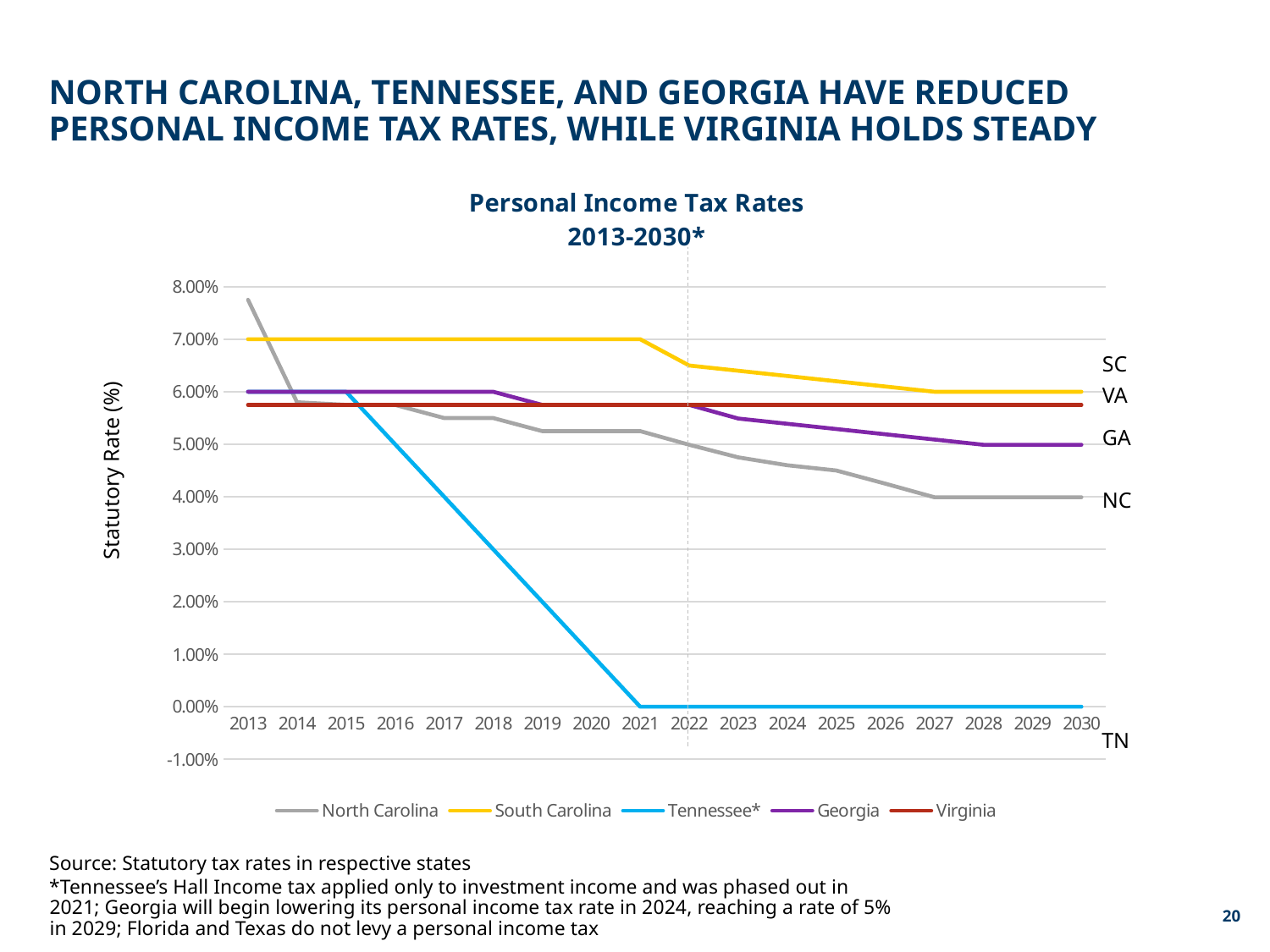
What is the Tennessee rate in 2025? 0.00% Which state has the lowest rate in 2013? Virginia What kind of chart is shown on the slide? line chart How many years are shown along the x axis? 18 Is the Virginia rate in 2020 greater or less than 5.00%? greater What is the South Carolina personal income tax rate in 2015? 7.00% Which series is drawn in yellow? South Carolina How many series does the legend list? 5 What is the Georgia rate in 2029? 5% Does the North Carolina rate rise or fall from 2013 to 2030? fall Which state has the highest rate in 2030? South Carolina